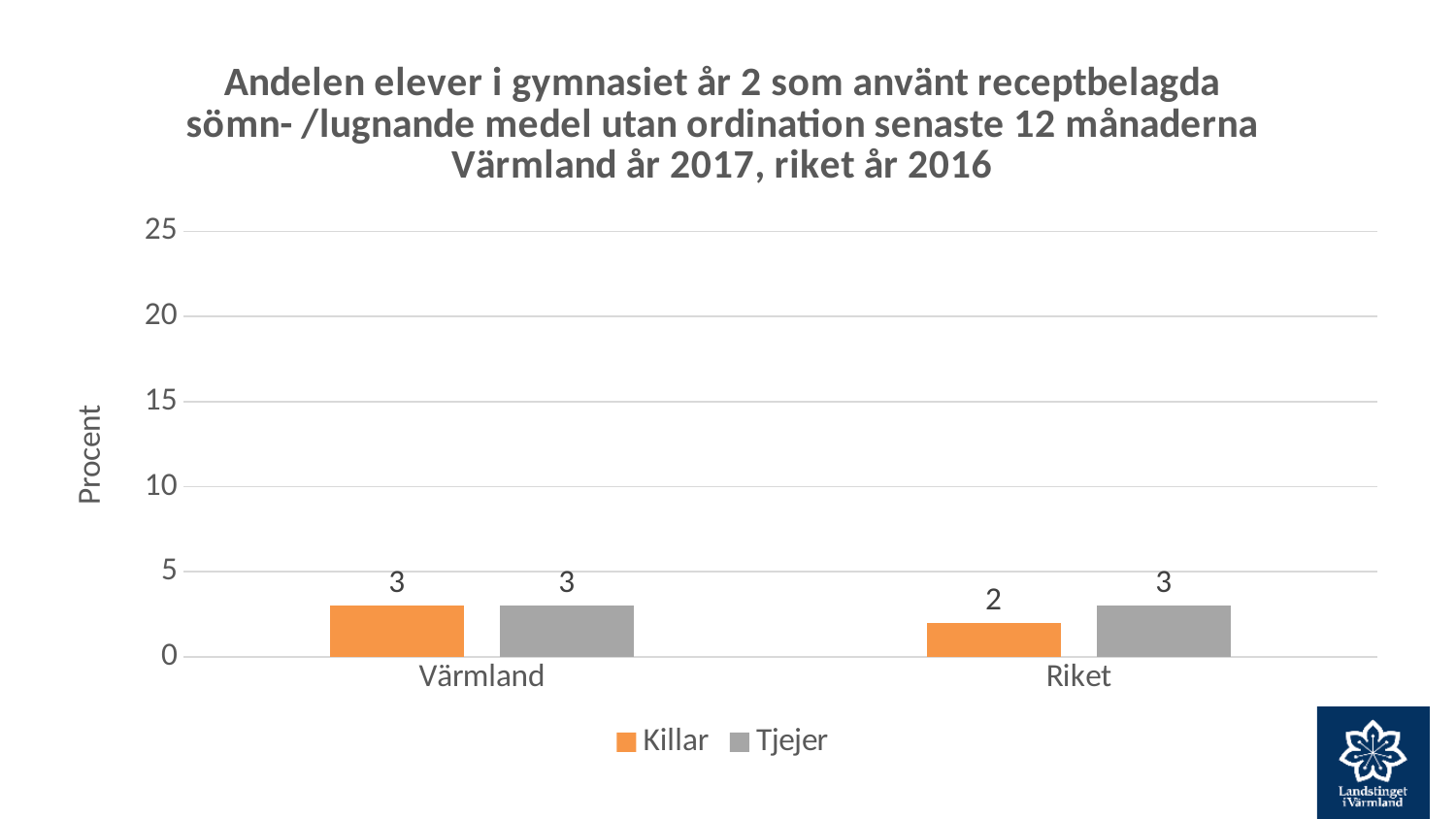
Which series has the lowest value in Riket? Killar What is the difference between the Tjejer and Killar values in Riket? 1 What is the value for Tjejer in Värmland? 3 What is the value for Tjejer in Riket? 3 Which is larger, the Killar value in Värmland or the Killar value in Riket? Värmland What is the value for Killar in Värmland? 3 How many series does the legend list? 2 Is the value for Tjejer in Riket greater or less than 5? less How many categories are shown on the x axis? 2 What is the label of the y axis? Procent What is the value for Killar in Riket? 2 What kind of chart is shown on the slide? bar chart